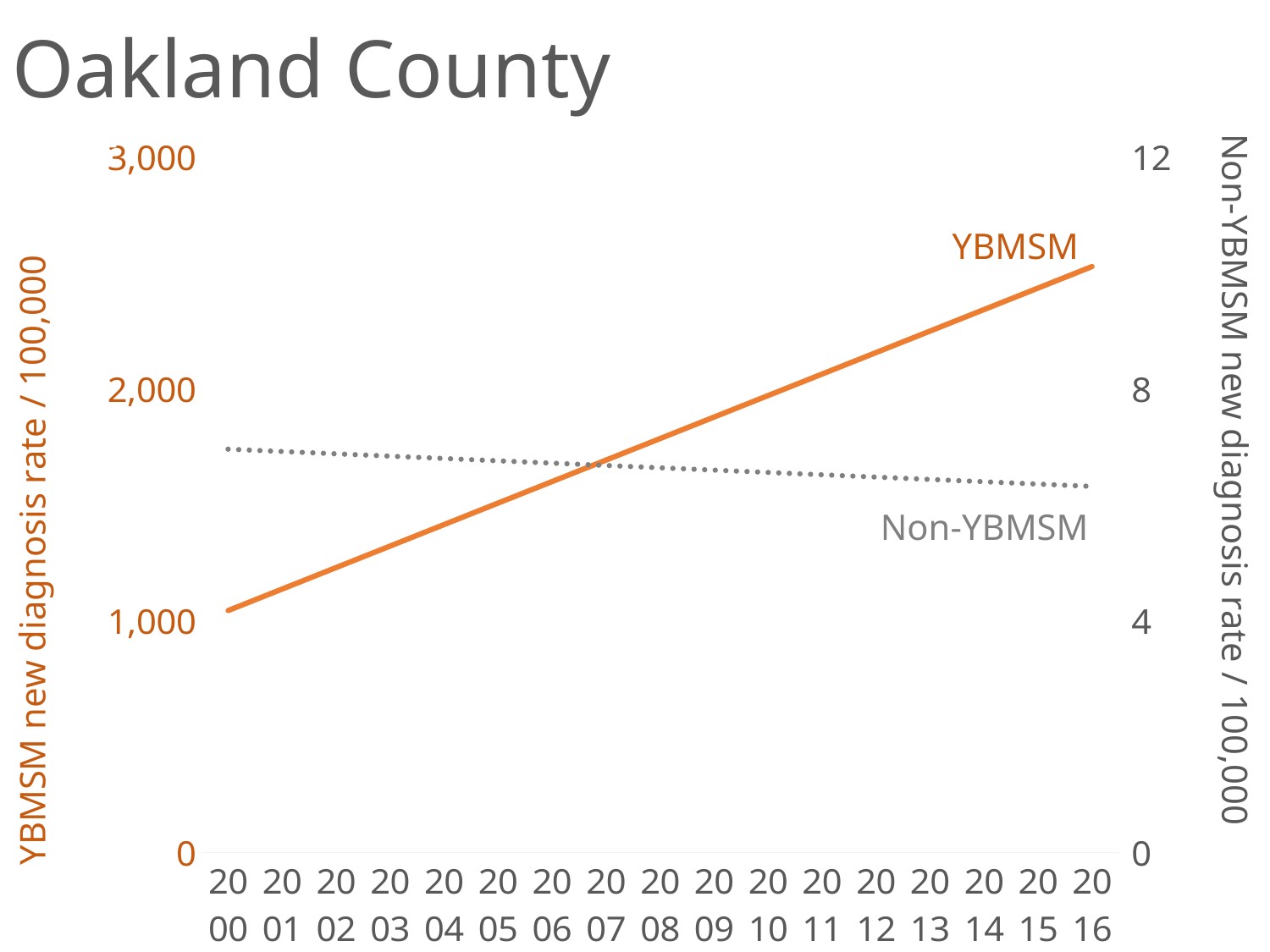
Does the Non-YBMSM line rise or fall from 2000 to 2016? fall Is the YBMSM value for 2016 greater or less than 2,000? greater What is the title of the chart? Oakland County Is the Non-YBMSM value for 2000 greater or less than 8? less How many years are shown along the x axis? 17 Does the YBMSM line rise or fall from 2000 to 2016? rise How many series are plotted on the chart? 2 What is the label of the left vertical axis? YBMSM new diagnosis rate / 100,000 Is the Non-YBMSM value for 2016 greater or less than 4? greater Which series is drawn as a dotted line? Non-YBMSM What kind of chart is shown on the slide? line chart